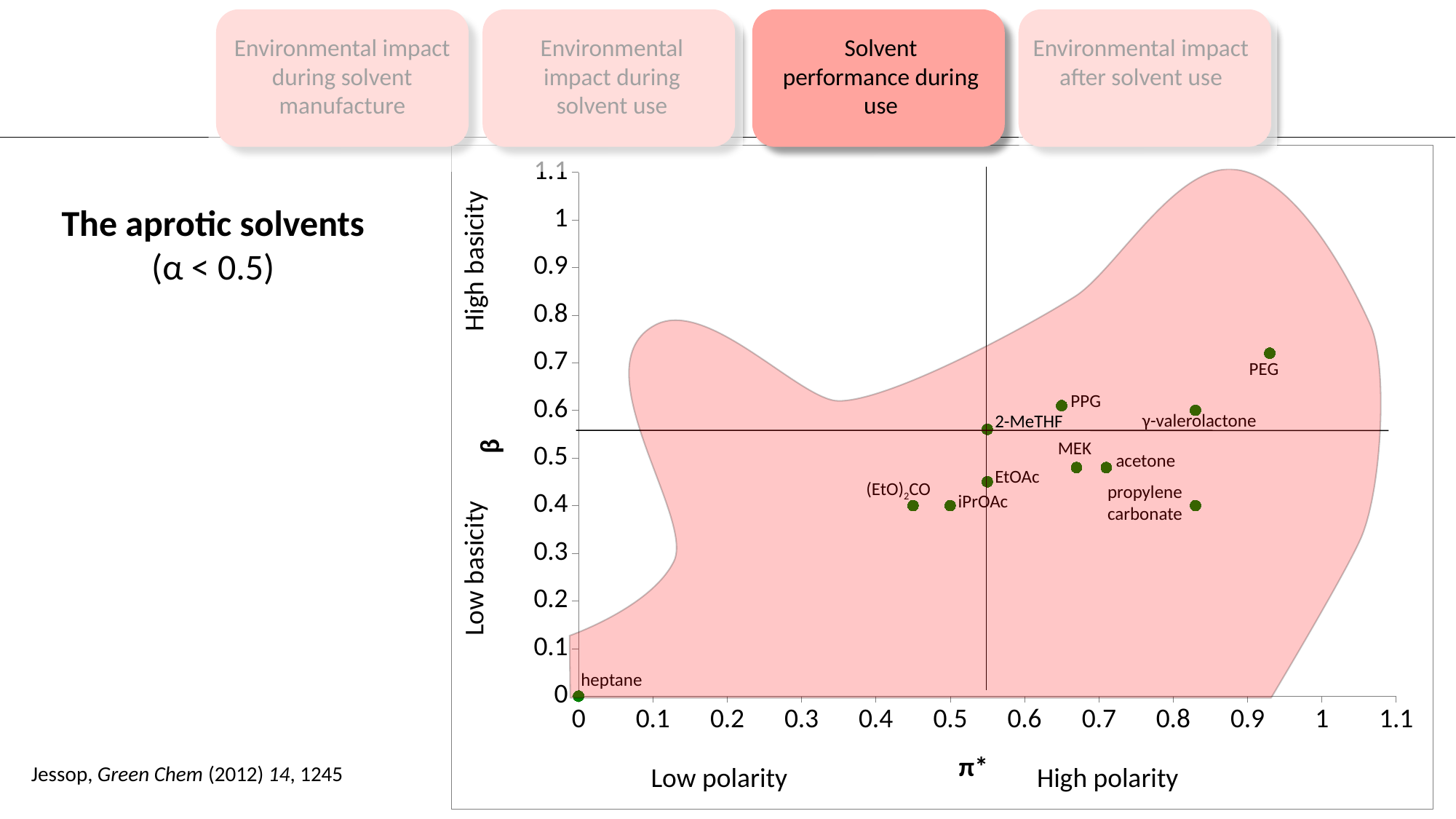
What is the β value for heptane? 0 What is the π* value for iPrOAc? 0.5 What kind of chart is shown on the slide? scatter chart What is the β value for propylene carbonate? 0.4 Is the π* value for MEK greater or less than 0.6? greater Which solvent has the highest β value? PEG How many labelled solvent points are plotted on the chart? 11 What symbol labels the x axis of the chart? π* Which solvent has the lowest π* value? heptane What is the β value for γ-valerolactone? 0.6 Is the π* value for PEG greater or less than 0.8? greater Which has the larger β value, PEG or PPG? PEG